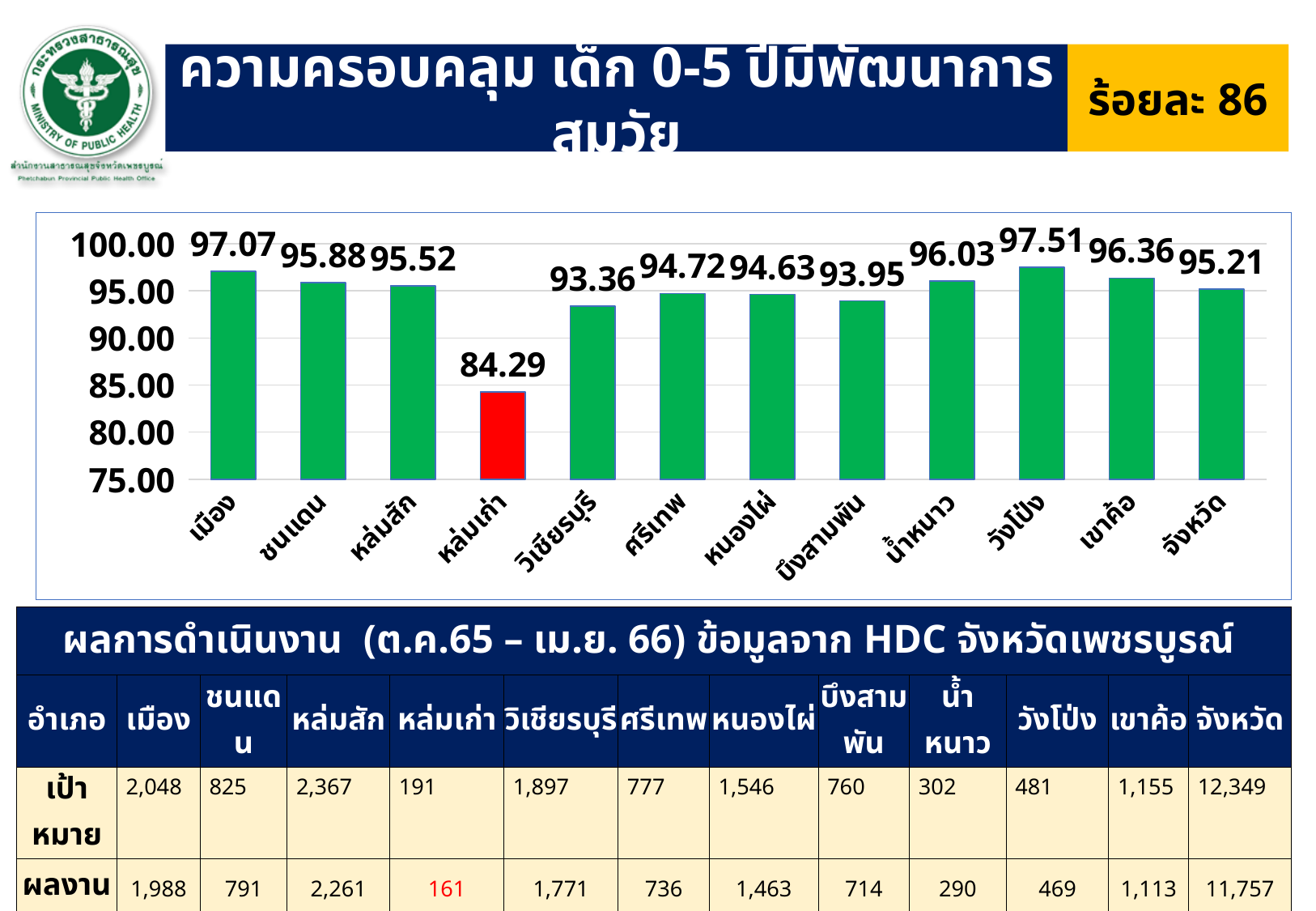
How many bars (categories) are plotted in the chart? 12 What is the value shown for จังหวัด? 95.21 What is the value shown for เมือง? 97.07 Which category has the lowest value in the chart? หล่มเก่า Which category has the highest value in the chart? วังโป่ง What is the value shown for วิเชียรบุรี? 93.36 Which has a larger value, น้ำหนาว or เขาค้อ? เขาค้อ What is the difference between the values for วังโป่ง and หล่มเก่า? 13.22 Is the value for หล่มเก่า greater or less than 85.00? less What is the value shown for หล่มเก่า? 84.29 What type of chart is shown on the slide? bar chart Which bar in the chart is coloured red rather than green? หล่มเก่า